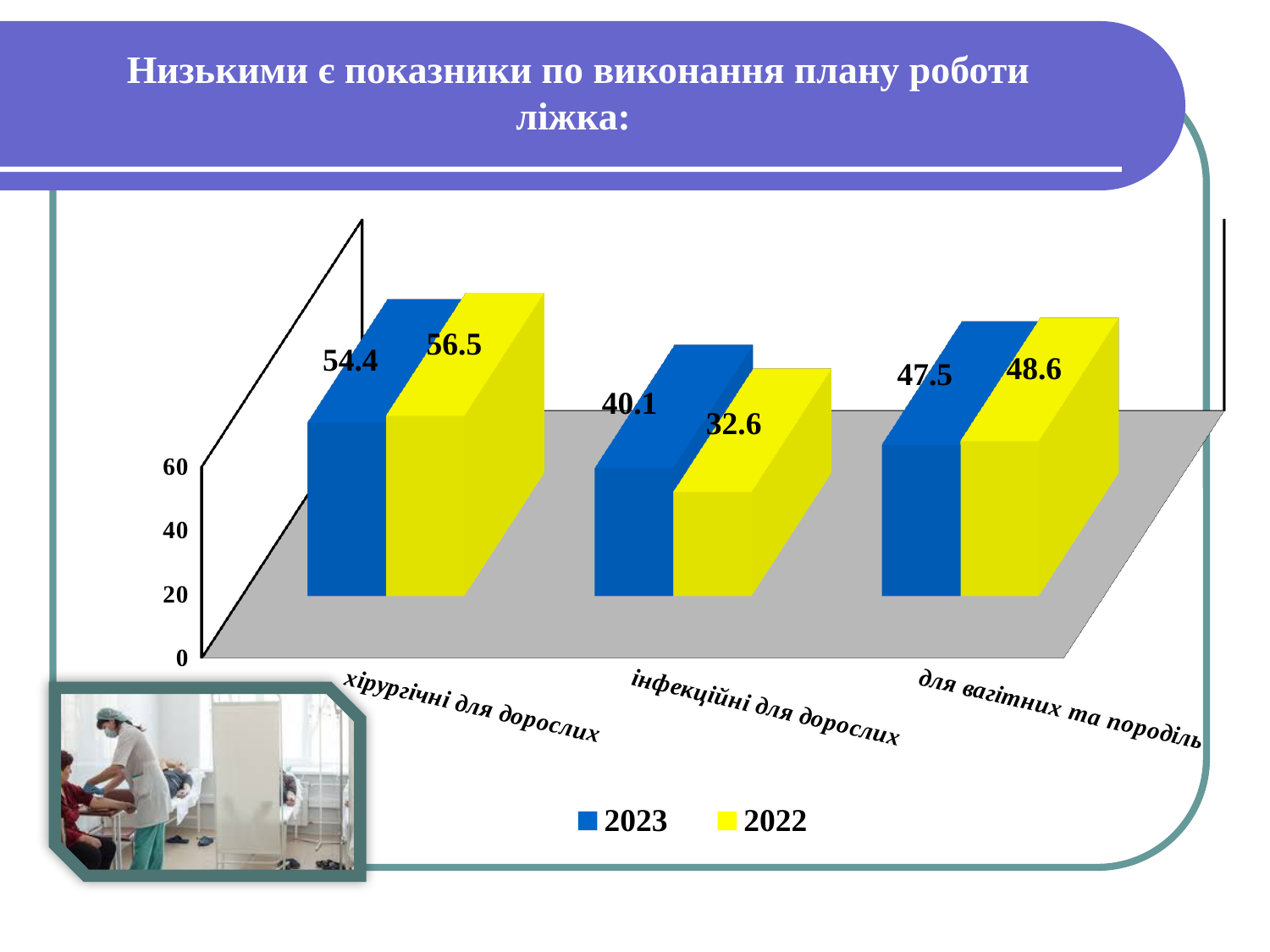
What is the value for 2023 for the category "хірургічні для дорослих"? 54.4 What kind of chart is shown on the slide? bar chart Which category has the highest value for the 2022 series? хірургічні для дорослих What is the value for 2022 for the category "інфекційні для дорослих"? 32.6 What is the difference between the 2022 and 2023 values for "для вагітних та породіль"? 1.1 Which colour represents the 2022 series in the chart? yellow Which category has the lowest value for the 2023 series? інфекційні для дорослих How many categories are shown on the x axis of the chart? 3 What is the value for 2022 for the category "для вагітних та породіль"? 48.6 For "хірургічні для дорослих", which series has the larger value, 2023 or 2022? 2022 What is the difference between the 2023 and 2022 values for "інфекційні для дорослих"? 7.5 How many series does the chart legend list? 2